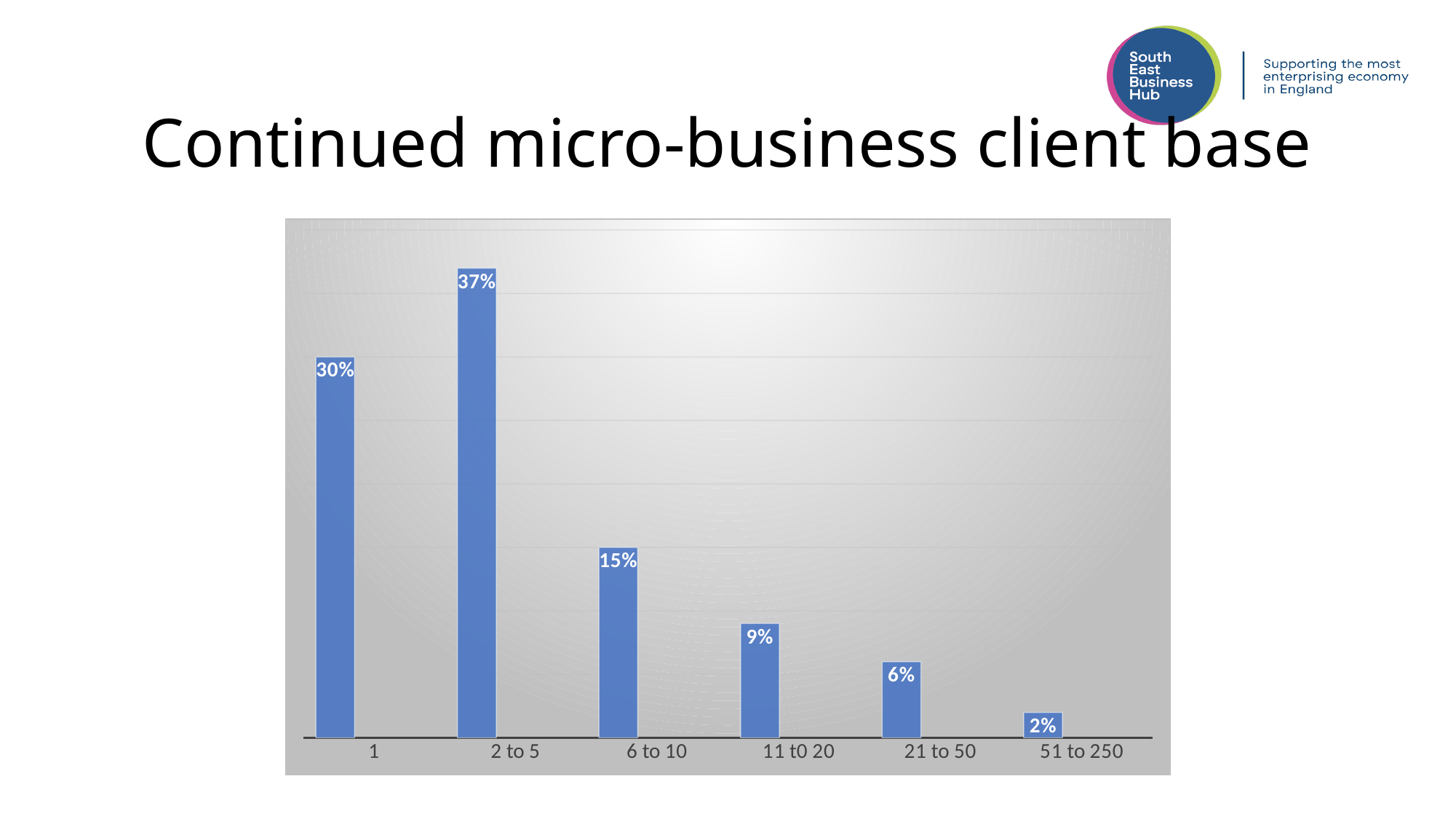
Which is larger, the value for "21 to 50" or the value for "11 t0 20"? 11 t0 20 What is the difference between the values for "6 to 10" and "11 t0 20"? 6% What is the title of the slide containing the chart? Continued micro-business client base What is the difference between the values for "2 to 5" and "1"? 7% Which category has the lowest value? 51 to 250 What is the value for the "6 to 10" category? 15% What kind of chart is shown on the slide? Bar chart What is the value for the "2 to 5" category? 37% What is the value for the "1" category? 30% What is the value for the "51 to 250" category? 2% Which category has the highest value? 2 to 5 How many categories are shown on the x axis? 6